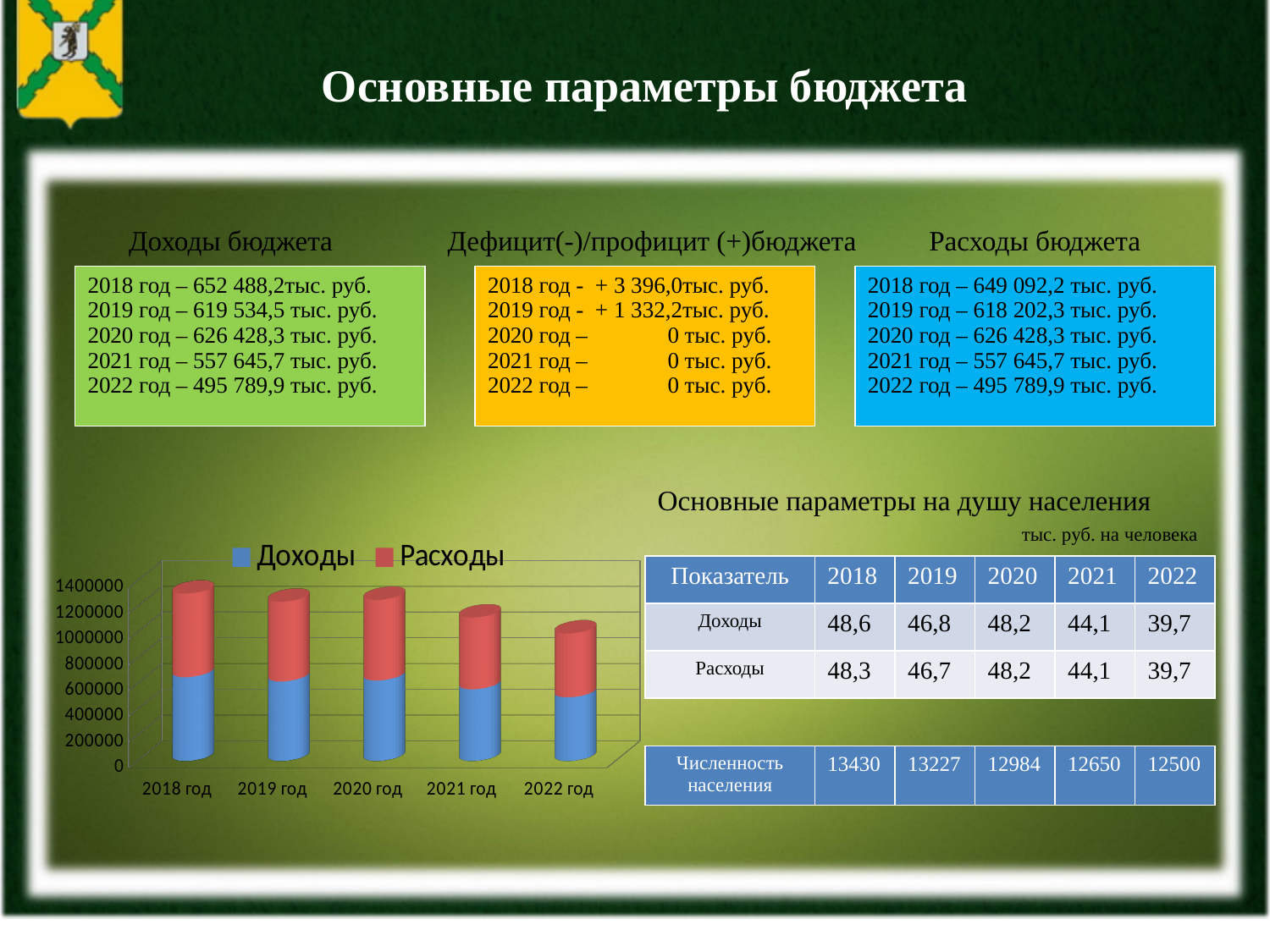
How many series does the chart's legend list? 2 What kind of chart is shown on the slide? bar chart Which stacked bar is taller, 2018 год or 2022 год? 2018 год Do the stacked bar totals generally rise or fall from 2018 год to 2022 год? fall Which year has the tallest stacked bar in the chart? 2018 год Is the Доходы segment for 2022 год greater or less than 600000? less Which year has the shortest stacked bar in the chart? 2022 год How many year categories are shown on the chart's x axis? 5 Which colour represents the Доходы series in the chart? blue Is the total height of the stacked bar for 2022 год greater or less than 1200000? less Is the total height of the stacked bar for 2018 год greater or less than 1200000? greater